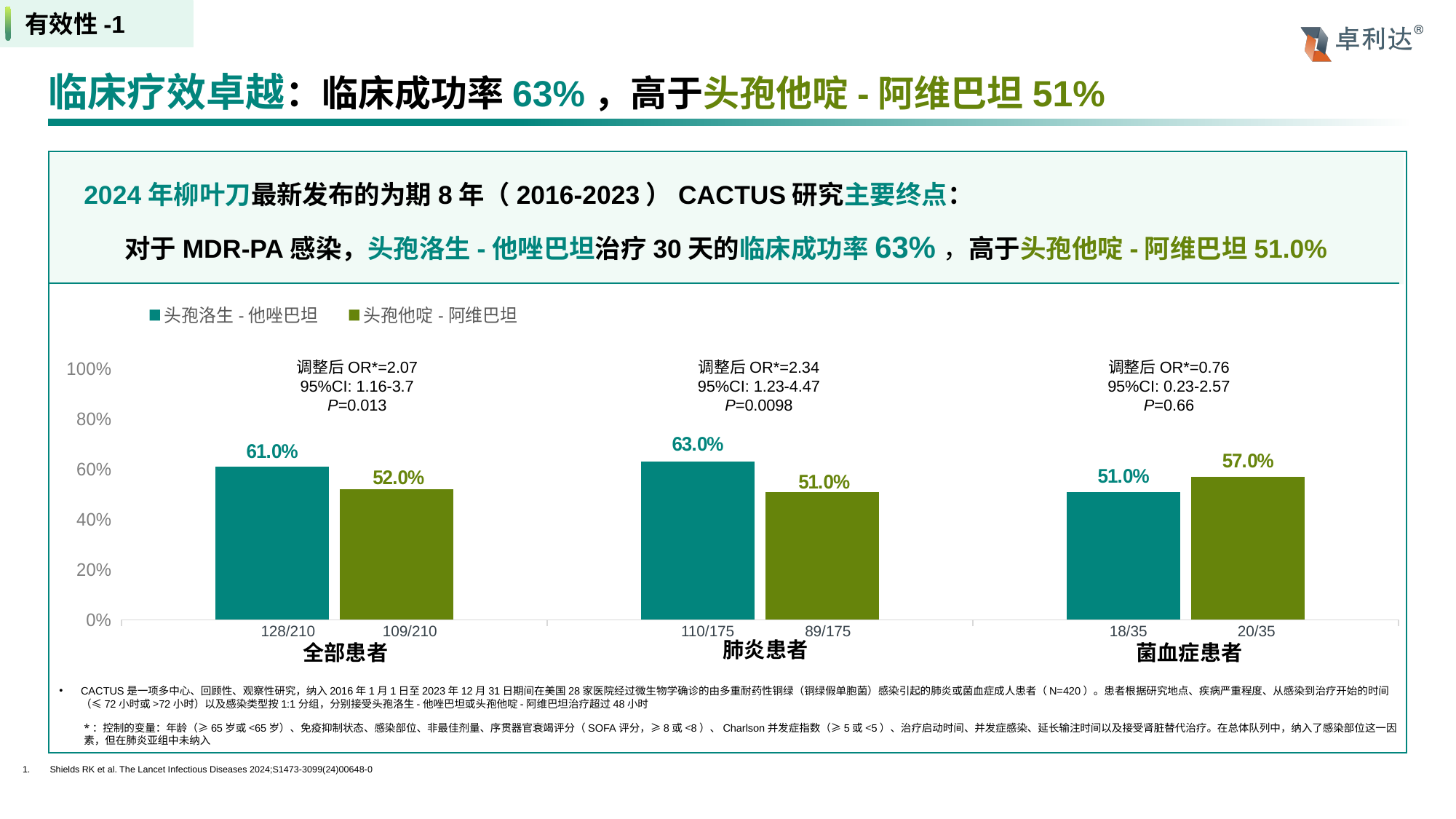
How many patient groups are shown on the x axis? 3 What is the difference between 头孢洛生-他唑巴坦 and 头孢他啶-阿维巴坦 in the 肺炎患者 group? 12.0% In which patient group does 头孢洛生-他唑巴坦 have its lowest value? 菌血症患者 In the 菌血症患者 group, which series has the larger value, 头孢洛生-他唑巴坦 or 头孢他啶-阿维巴坦? 头孢他啶-阿维巴坦 What is the value for 头孢他啶-阿维巴坦 in the 菌血症患者 group? 57.0% What is the value for 头孢洛生-他唑巴坦 in the 全部患者 group? 61.0% What is the adjusted OR shown above the 肺炎患者 group? 2.34 How many series does the legend list? 2 Is the value for 头孢洛生-他唑巴坦 in the 全部患者 group greater or less than 40%? greater What kind of chart is shown on the slide? bar chart In which patient group does 头孢洛生-他唑巴坦 have its highest value? 肺炎患者 What is the value for 头孢他啶-阿维巴坦 in the 肺炎患者 group? 51.0%